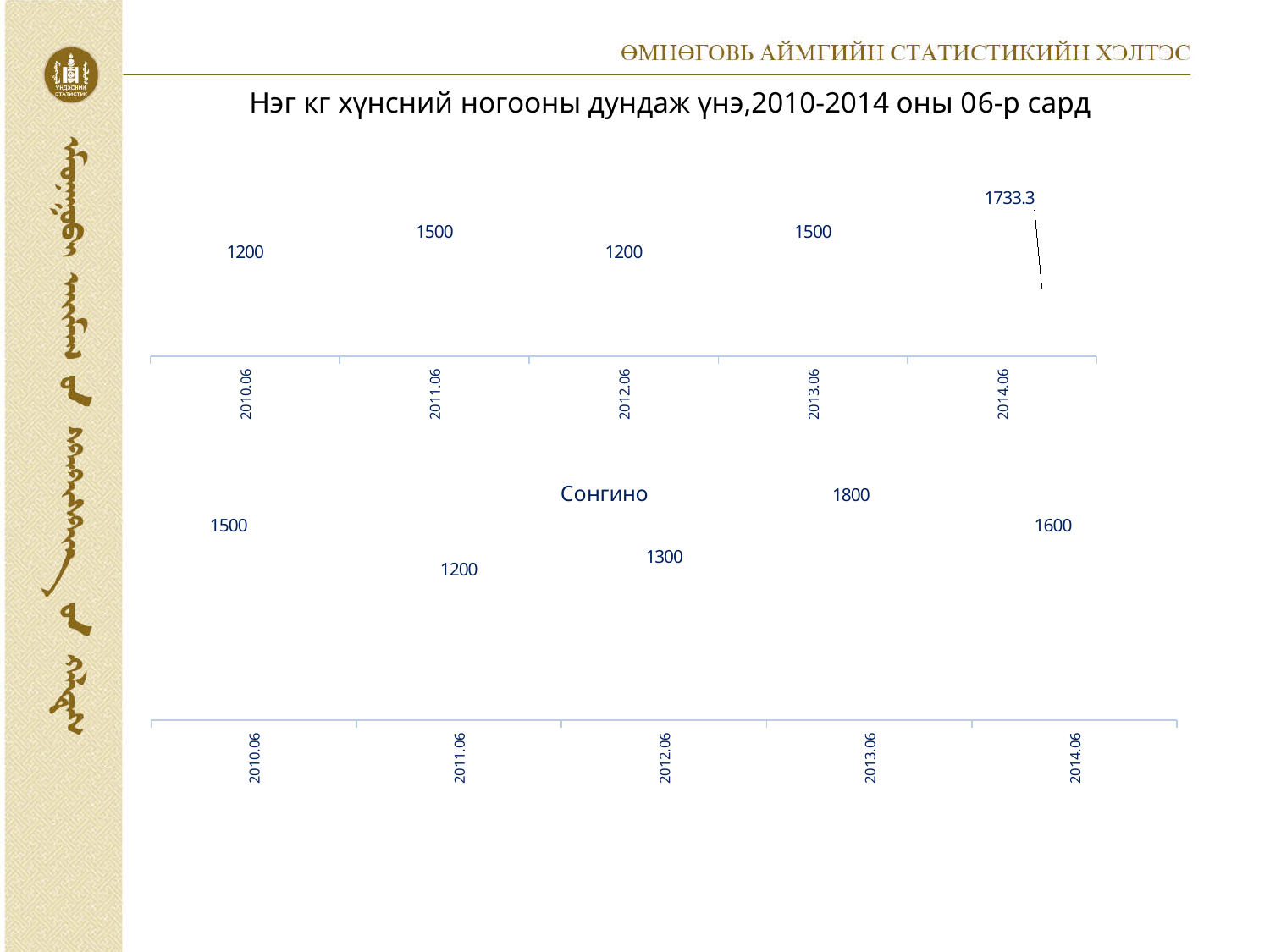
How many categories are shown on the x axis of the top chart? 5 In the top chart, what is the difference between the values for 2014.06 and 2013.06? 233.3 In the top chart, what is the value for 2014.06? 1733.3 In the chart titled Сонгино, which category has the lowest value? 2011.06 In the chart titled Сонгино, what is the value for 2012.06? 1300 In the top chart, what is the value for 2011.06? 1500 In the chart titled Сонгино, what is the value for 2013.06? 1800 In the chart titled Сонгино, what is the difference between the values for 2013.06 and 2014.06? 200 In the chart titled Сонгино, which is larger, the value for 2010.06 or the value for 2011.06? 2010.06 In the chart titled Сонгино, which category has the highest value? 2013.06 In the top chart, which category has the highest value? 2014.06